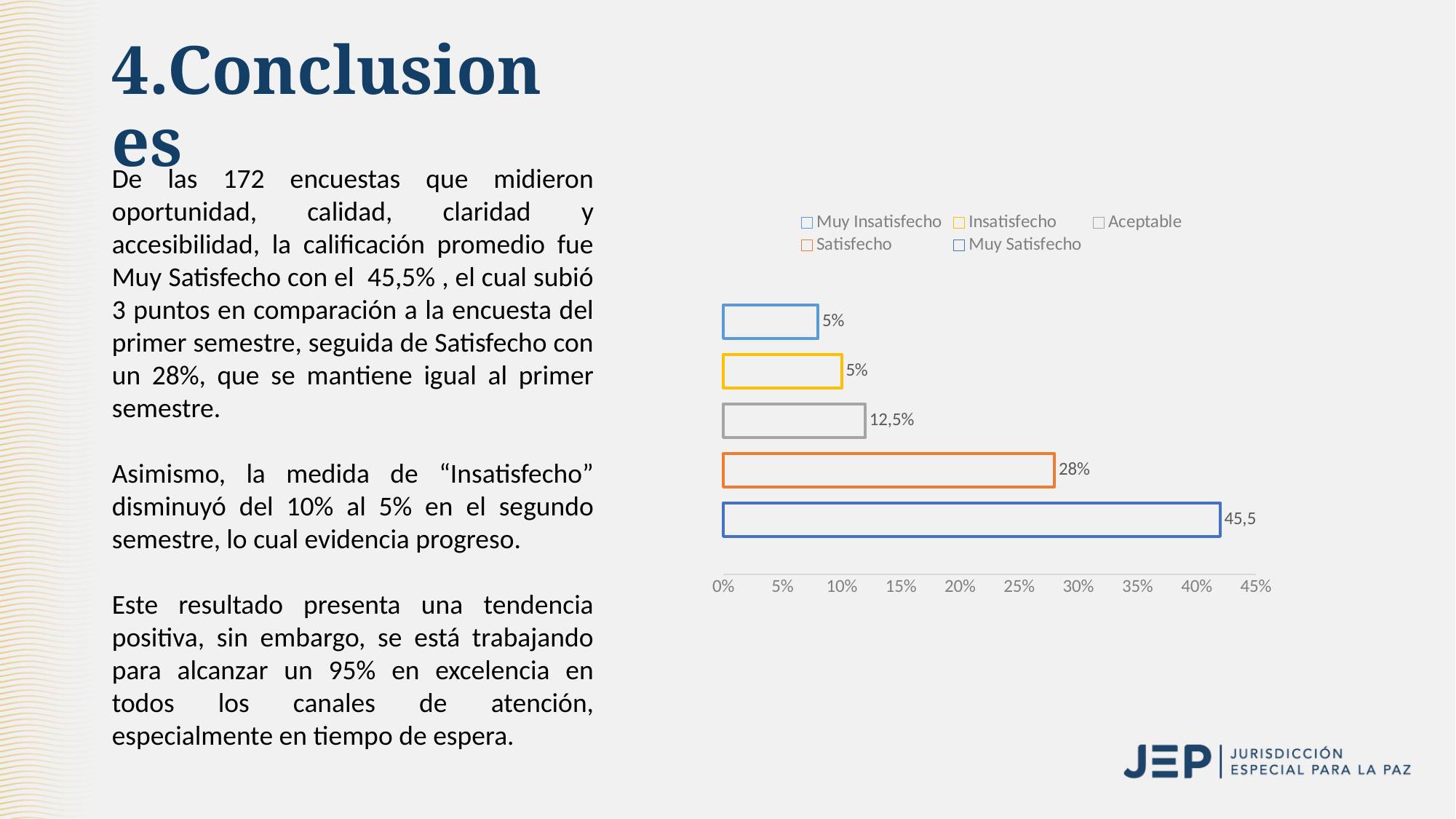
Which is larger, the value for Satisfecho or the value for Aceptable? Satisfecho What is the difference between the values for Satisfecho and Aceptable? 15,5% What is the value shown for Aceptable? 12,5% Is the value for Satisfecho greater or less than 25%? greater What colour is the bar for Satisfecho? orange What is the value shown for Muy Insatisfecho? 5% What is the value shown for Satisfecho? 28% What is the value shown for Insatisfecho? 5% How many series does the legend list? 5 What is the value shown for Muy Satisfecho? 45,5 What kind of chart is shown on the slide? bar chart Which category has the highest value? Muy Satisfecho